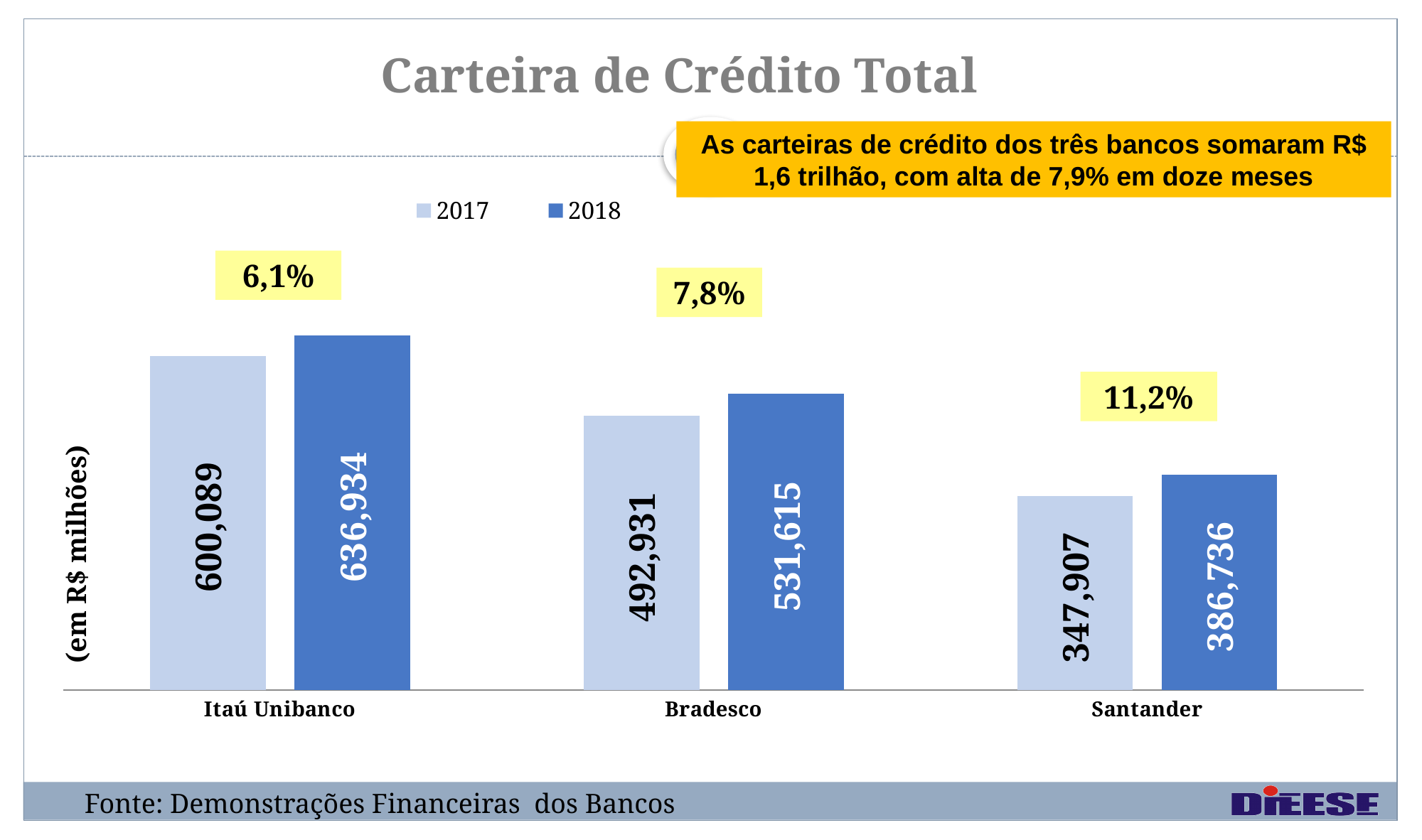
What is the 2018 value for Itaú Unibanco? 636,934 How many series does the legend list? 2 Which bank has the lowest 2017 value? Santander What is the 2017 value for Santander? 347,907 What is the 2018 value for Santander? 386,736 What is the 2017 value for Bradesco? 492,931 What is the difference between the 2018 and 2017 values for Itaú Unibanco? 36,845 What is the difference between the 2018 and 2017 values for Bradesco? 38,684 What percentage growth is shown above the Santander bars? 11,2% What type of chart is shown on the slide? bar chart Which is larger: the 2017 value for Itaú Unibanco or the 2018 value for Bradesco? 2017 value for Itaú Unibanco Which bank has the highest 2018 value? Itaú Unibanco